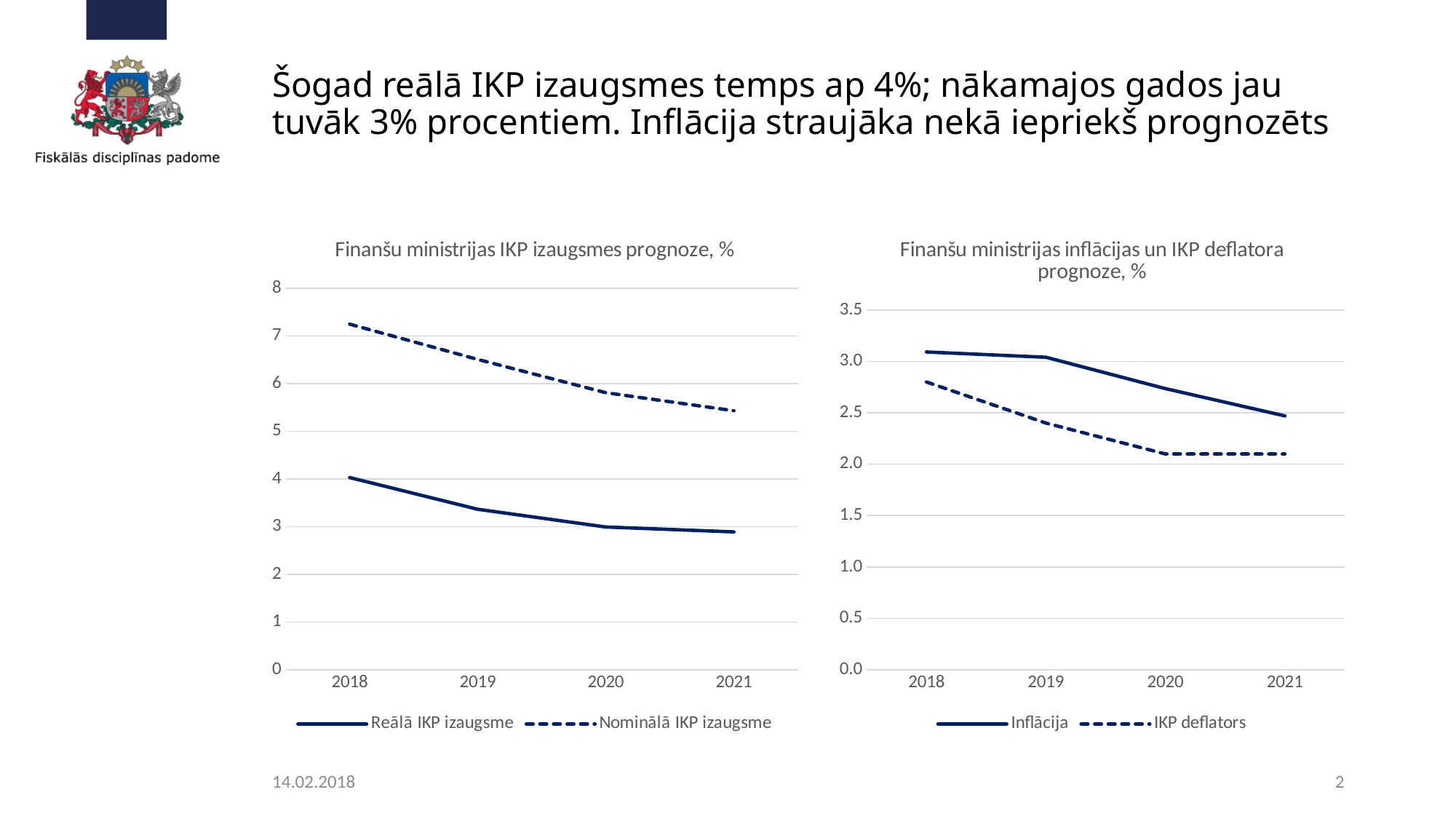
In the left chart, 'Finanšu ministrijas IKP izaugsmes prognoze, %', is the value for Nominālā IKP izaugsme in 2018 greater or less than 7? greater In the right chart, 'Finanšu ministrijas inflācijas un IKP deflatora prognoze, %', which series is larger in 2020, Inflācija or IKP deflators? Inflācija In the right chart, 'Finanšu ministrijas inflācijas un IKP deflatora prognoze, %', does the Inflācija series rise or fall from 2019 to 2021? fall In the left chart, 'Finanšu ministrijas IKP izaugsmes prognoze, %', is the value for Nominālā IKP izaugsme in 2021 greater or less than 5? greater How many years are shown on the x axis of the left chart, 'Finanšu ministrijas IKP izaugsmes prognoze, %'? 4 How many series does the legend of the right chart, 'Finanšu ministrijas inflācijas un IKP deflatora prognoze, %', list? 2 In the left chart, 'Finanšu ministrijas IKP izaugsmes prognoze, %', which series is larger in 2019, Reālā IKP izaugsme or Nominālā IKP izaugsme? Nominālā IKP izaugsme In the right chart, 'Finanšu ministrijas inflācijas un IKP deflatora prognoze, %', which series is drawn with a dashed line? IKP deflators In the left chart, 'Finanšu ministrijas IKP izaugsmes prognoze, %', does the Nominālā IKP izaugsme series rise or fall from 2018 to 2021? fall What kind of chart is the left chart, 'Finanšu ministrijas IKP izaugsmes prognoze, %'? line chart In the right chart, 'Finanšu ministrijas inflācijas un IKP deflatora prognoze, %', is the value for IKP deflators in 2018 greater or less than 2.5? greater In the left chart, 'Finanšu ministrijas IKP izaugsmes prognoze, %', in which year is Nominālā IKP izaugsme highest? 2018